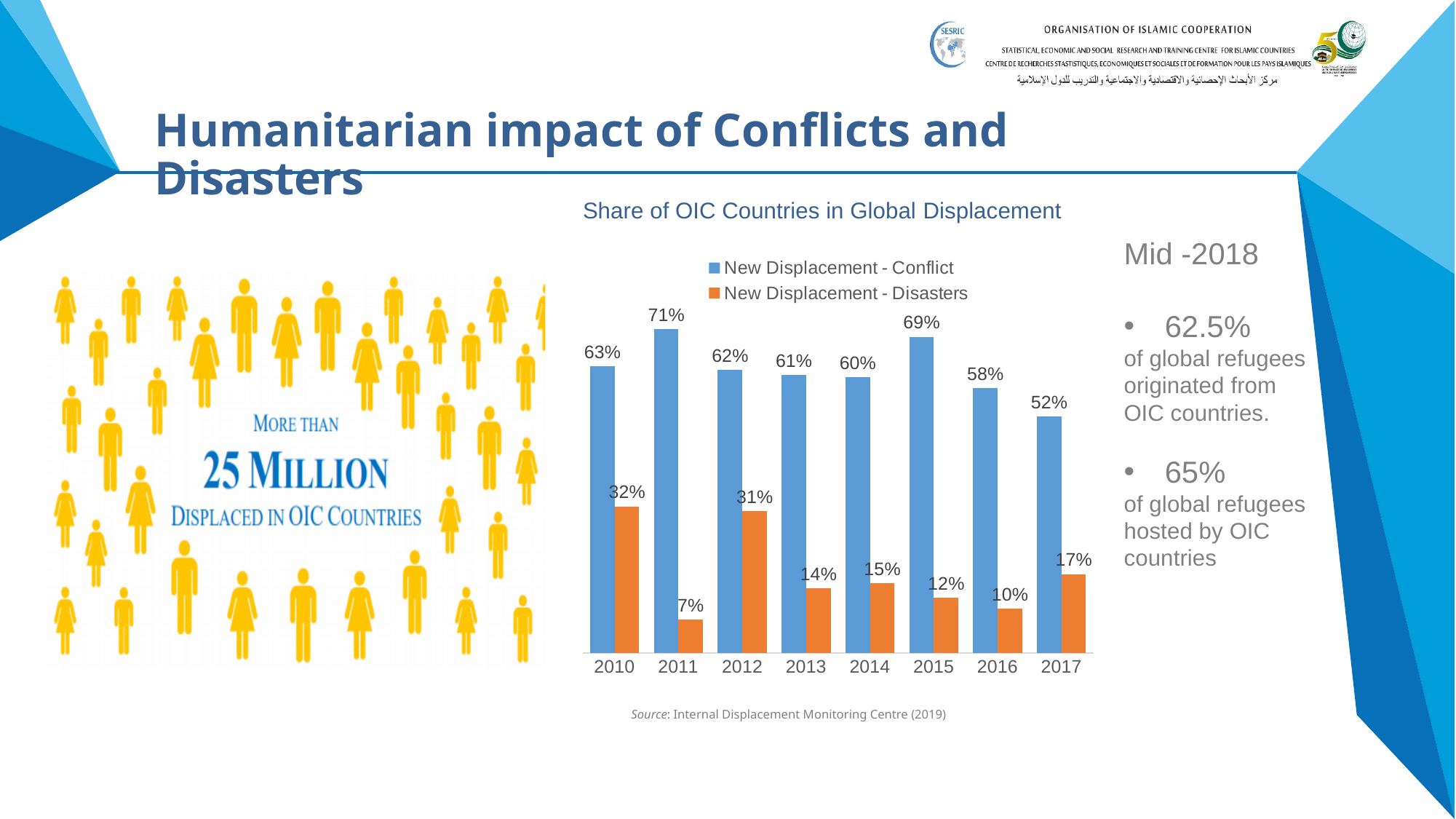
What is the value for New Displacement - Disasters in 2013? 14% Which year has the lowest value for New Displacement - Disasters? 2011 What kind of chart is shown? bar chart What is the value for New Displacement - Conflict in 2017? 52% What is the value for New Displacement - Conflict in 2011? 71% Which is larger: New Displacement - Disasters in 2012 or in 2014? 2012 Does New Displacement - Conflict rise or fall from 2015 to 2017? fall What is the title of the chart? Share of OIC Countries in Global Displacement What is the difference between New Displacement - Conflict and New Displacement - Disasters in 2010? 31% How many years are shown on the x axis? 8 Which year has the highest value for New Displacement - Conflict? 2011 How many series does the legend list? 2